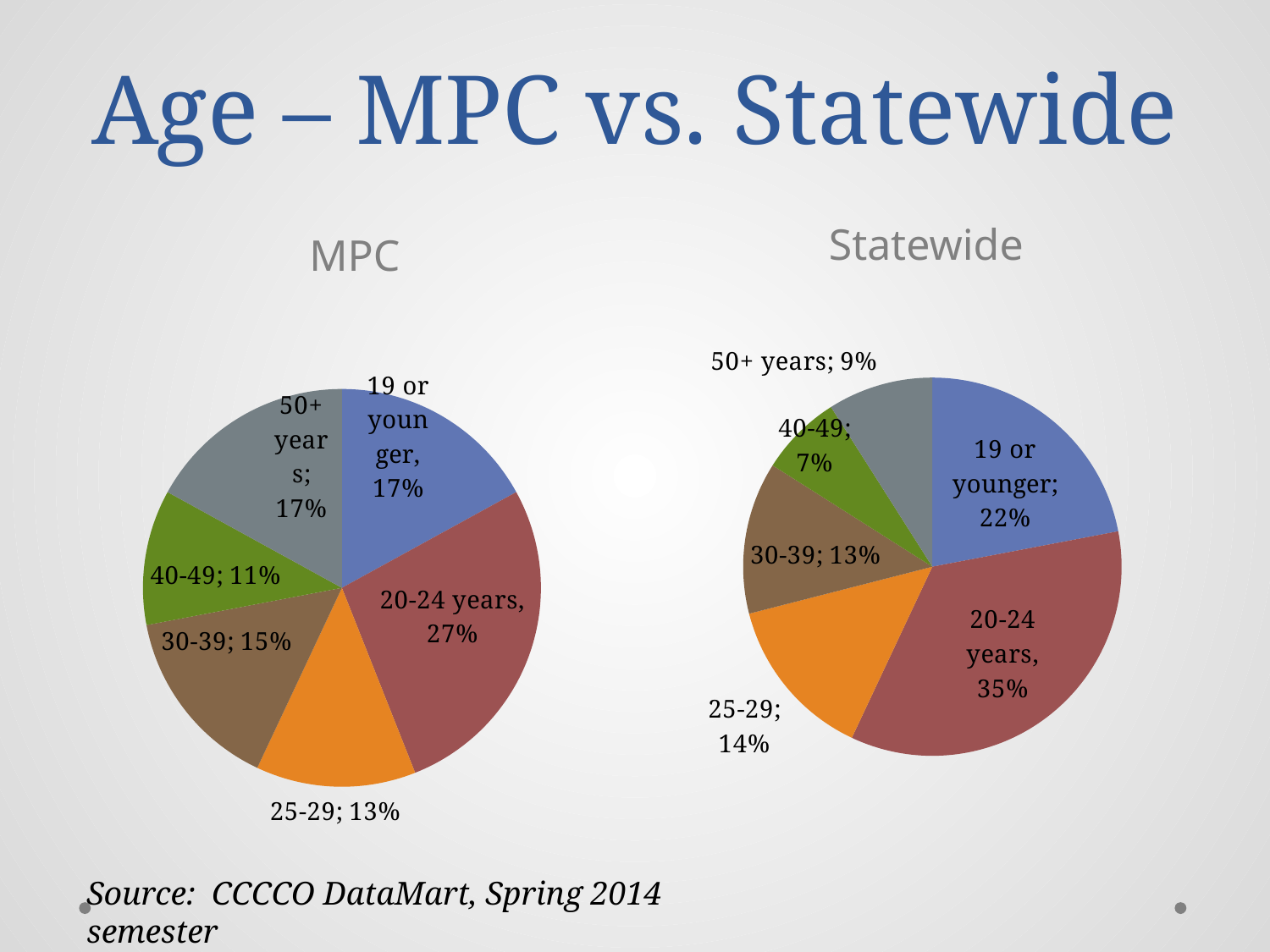
In the MPC pie chart, what share is the 20-24 years slice? 27% In the Statewide pie chart, what share is the 19 or younger slice? 22% In the MPC pie chart, which age group has the smallest share? 40-49 Which is larger: the 50+ years share in the MPC chart or in the Statewide chart? MPC In the MPC pie chart, what share is the 25-29 slice? 13% In the MPC pie chart, which age group has the largest share? 20-24 years What type of chart is used for the Statewide data? Pie chart In the Statewide pie chart, which age group has the smallest share? 40-49 In the Statewide pie chart, what share is the 40-49 slice? 7% What is the title of the slide containing the two charts? Age – MPC vs. Statewide What is the difference between the 20-24 years share in the Statewide chart and in the MPC chart? 8 percentage points How many slices does the MPC pie chart have? 6